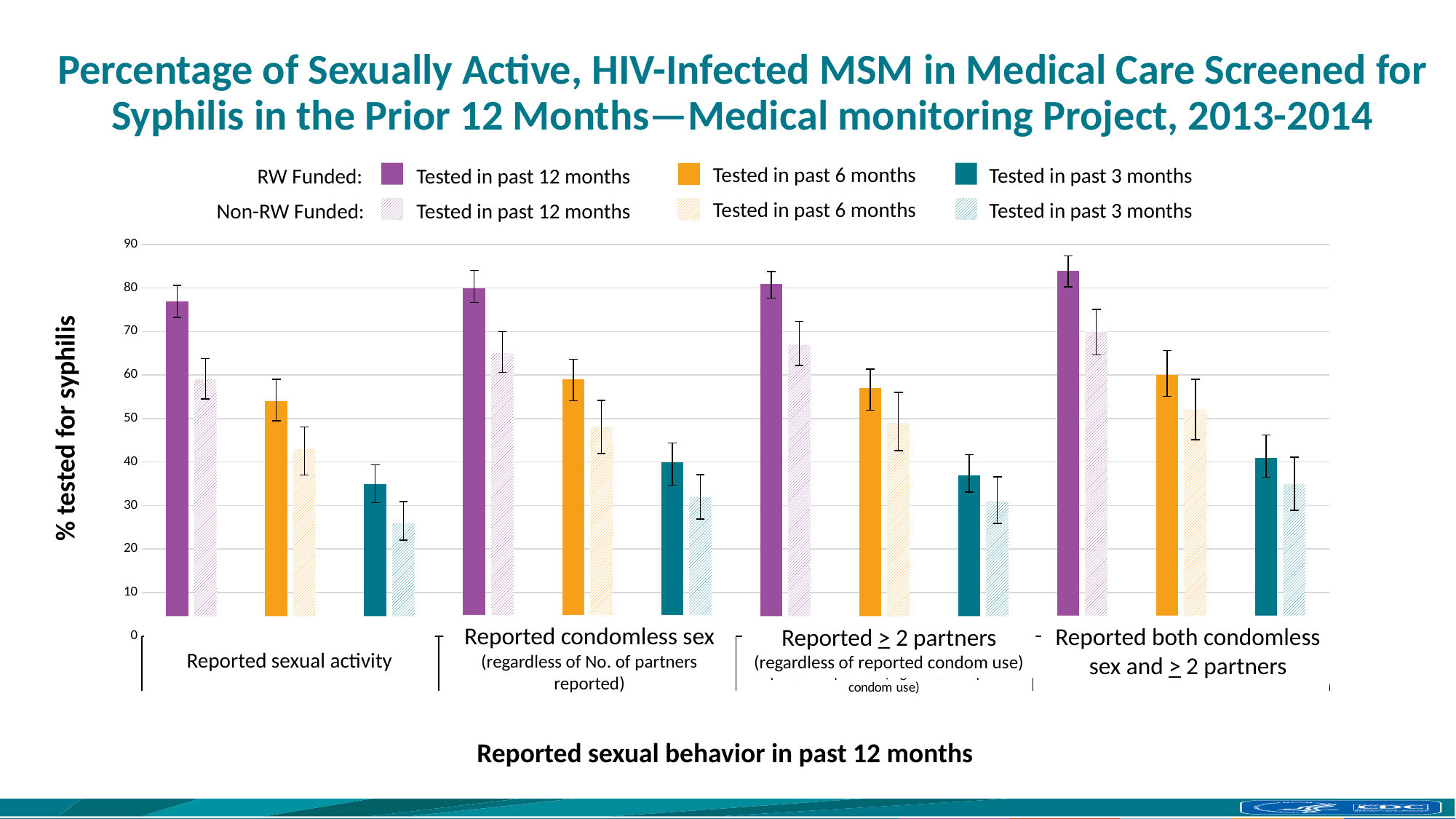
What kind of chart is shown on the slide? bar chart Within the Reported sexual activity category, which series has the lowest bar? Non-RW Funded: Tested in past 3 months For Reported ≥ 2 partners, which is larger: the RW Funded or the Non-RW Funded 'Tested in past 6 months' value? RW Funded What is the title of the y axis? % tested for syphilis Is the RW Funded 'Tested in past 3 months' value for Reported condomless sex greater or less than 50? less Is the Non-RW Funded 'Tested in past 3 months' value for Reported sexual activity greater or less than 30? less Within the Reported sexual activity category, which series has the highest bar? RW Funded: Tested in past 12 months Is the RW Funded 'Tested in past 12 months' value for Reported sexual activity greater or less than 70? greater How many reported sexual behavior categories are shown on the x axis? 4 For Reported both condomless sex and ≥ 2 partners, which is larger: the RW Funded or the Non-RW Funded 'Tested in past 12 months' value? RW Funded How many series does the legend list? 6